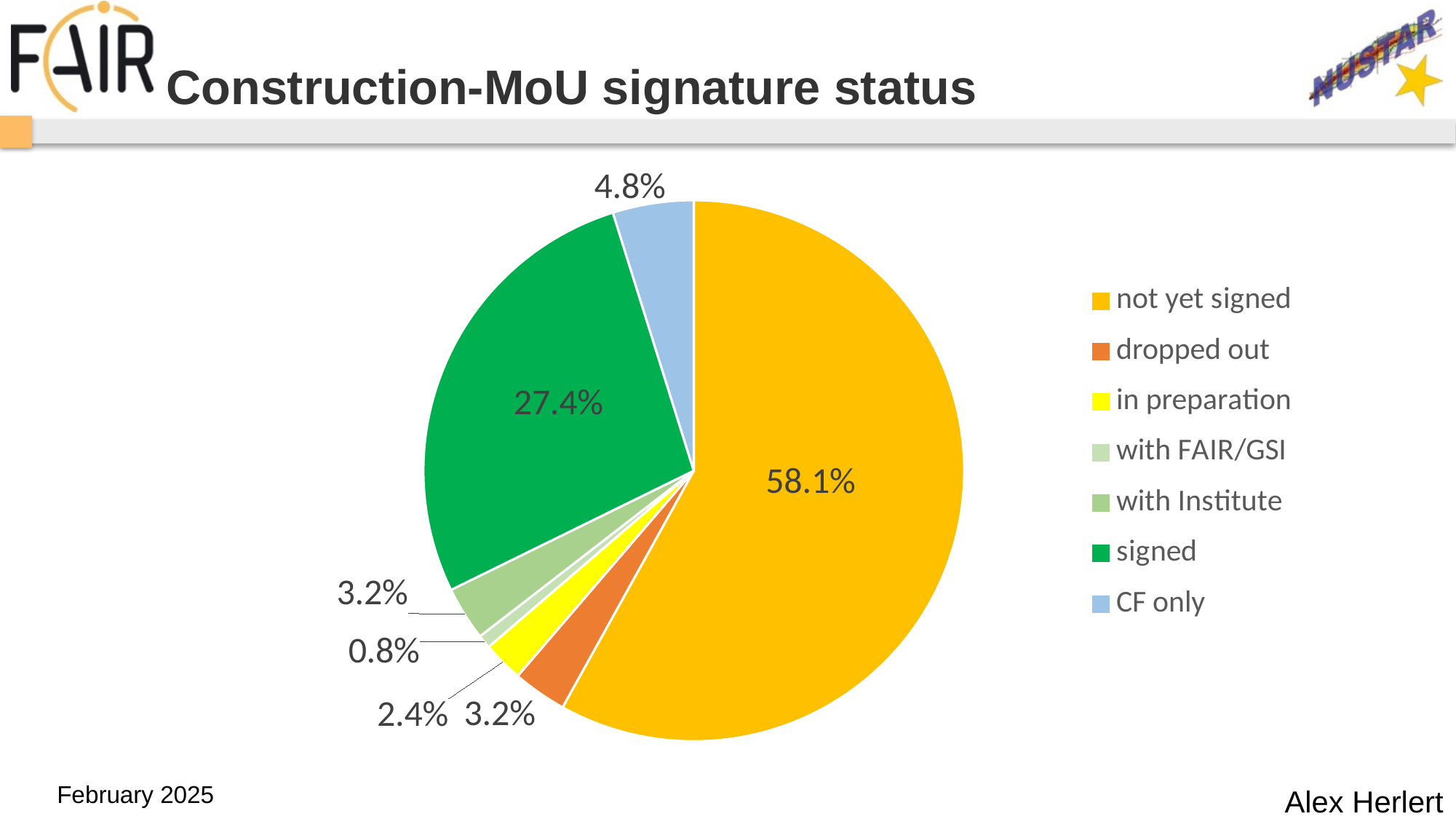
What type of chart is shown on the slide? pie chart What is the title of the chart on the slide? Construction-MoU signature status What share of the pie is labelled 'CF only'? 4.8% What share of the pie is labelled 'not yet signed'? 58.1% What share of the pie is labelled 'signed'? 27.4% What share of the pie is labelled 'in preparation'? 2.4% Which category has the largest slice of the pie? not yet signed How many categories does the legend list? 7 Which category has the smallest slice of the pie? with FAIR/GSI Which is larger, the 'CF only' slice or the 'in preparation' slice? CF only What is the difference in percentage points between 'not yet signed' and 'signed'? 30.7 What share of the pie is labelled 'with FAIR/GSI'? 0.8%